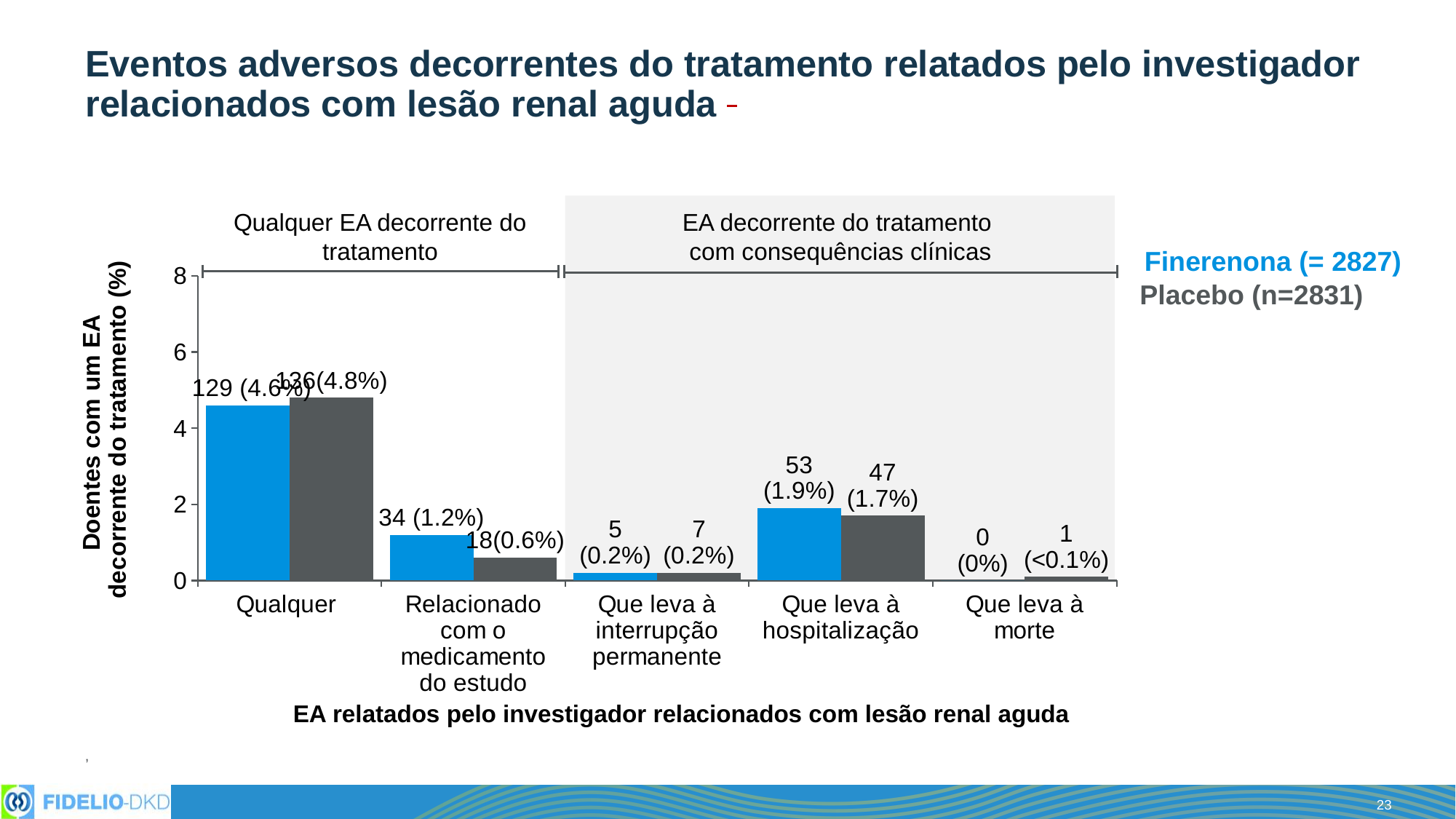
Which category has the highest value for Finerenona? Qualquer What is the data label for Placebo in the 'Que leva à morte' category? 1 (<0.1%) What is the difference in number of patients between Finerenona and Placebo in the 'Relacionado com o medicamento do estudo' category? 16 What type of chart is shown on the slide? bar chart In the 'Que leva à hospitalização' category, which series has the larger value, Finerenona or Placebo? Finerenona What is the data label for Placebo in the 'Que leva à hospitalização' category? 47 (1.7%) How many categories are shown on the x axis? 5 What is the data label for Finerenona in the 'Que leva à interrupção permanente' category? 5 (0.2%) Is the Finerenona value for 'Qualquer' greater or less than 4%? greater How many series does the legend list? 2 What is the data label for Finerenona in the 'Relacionado com o medicamento do estudo' category? 34 (1.2%) Which category has the lowest value for Placebo? Que leva à morte